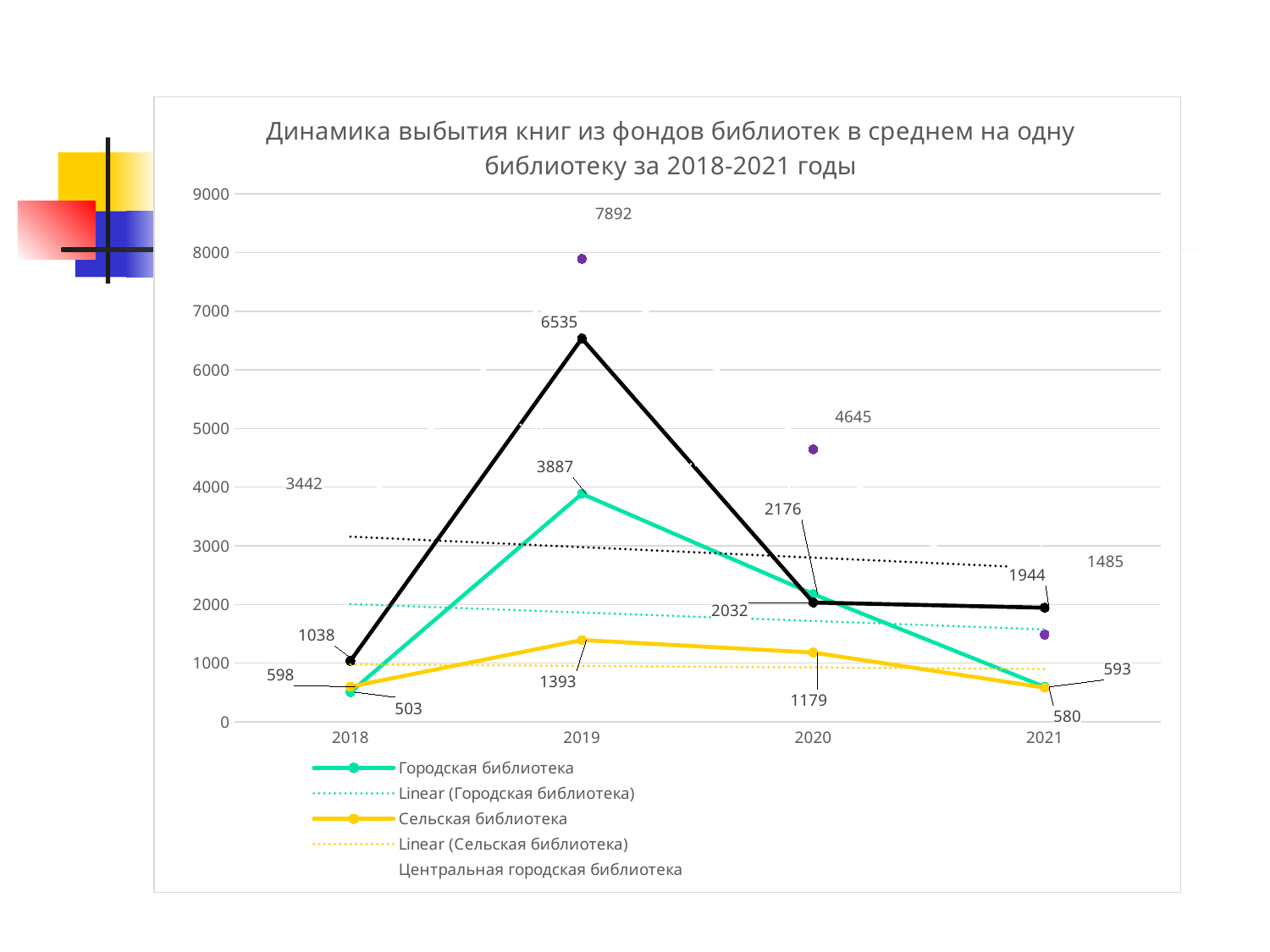
Is the value for Городская библиотека in 2019 greater or less than 3000? greater What kind of chart is this? line chart What is the value for Городская библиотека in 2019? 3887 Which is larger in 2020: Городская библиотека or Сельская библиотека? Городская библиотека How many entries does the legend list? 5 In which year is the value for Городская библиотека highest? 2019 What is the difference between Городская библиотека and Сельская библиотека in 2019? 2494 What is the value for Сельская библиотека in 2020? 1179 How many years are shown on the x axis? 4 What is the difference between Городская библиотека and Сельская библиотека in 2020? 997 What is the value for Городская библиотека in 2021? 593 In which year is the value for Сельская библиотека highest? 2019